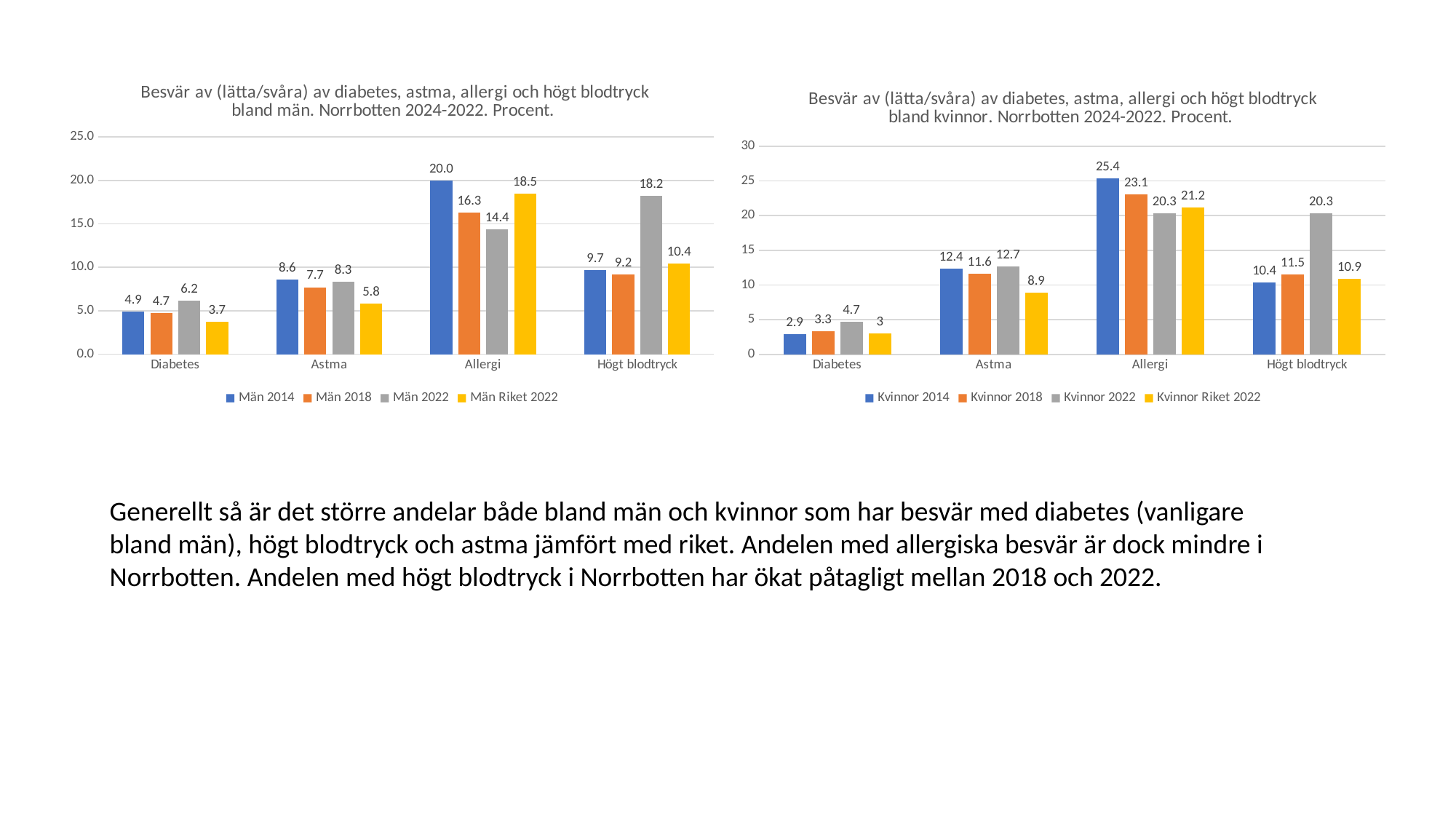
In the right chart (bland kvinnor), what colour represents Kvinnor 2022? Grey In the right chart (bland kvinnor), what is the difference between Kvinnor 2014 and Kvinnor Riket 2022 for Allergi? 4.2 How many series does the legend of the right chart (bland kvinnor) list? 4 In the left chart (bland män), what is the difference between Män 2022 and Män 2018 for Högt blodtryck? 9.0 In the right chart (bland kvinnor), which is larger for Högt blodtryck: Kvinnor 2022 or Kvinnor Riket 2022? Kvinnor 2022 In the left chart (bland män), what is the value for Män 2022 for Allergi? 14.4 In the left chart (bland män), which category has the highest value for Män 2014? Allergi In the right chart (bland kvinnor), which category has the lowest value for Kvinnor 2018? Diabetes In the left chart (bland män), which is larger for Diabetes: Män 2022 or Män Riket 2022? Män 2022 What kind of chart is the left chart (bland män)? Bar chart How many categories are shown on the x axis of the left chart (bland män)? 4 In the right chart (bland kvinnor), what is the value for Kvinnor Riket 2022 for Astma? 8.9